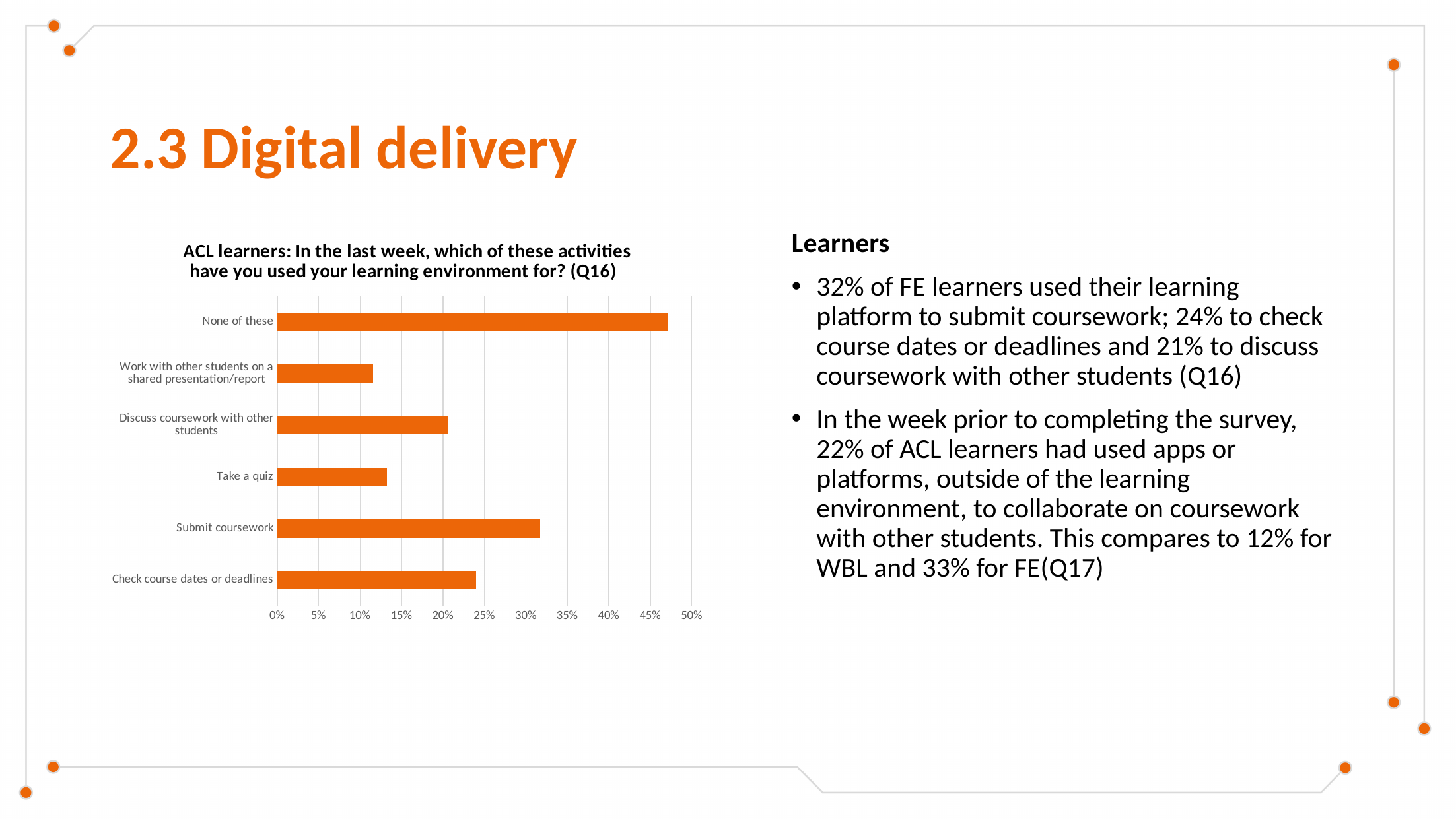
How many activity categories are plotted in the chart? 6 Which is larger: the value for "Submit coursework" or the value for "Check course dates or deadlines"? Submit coursework What is the title of the chart? ACL learners: In the last week, which of these activities have you used your learning environment for? (Q16) Which activity has the highest value in the chart? None of these Is the value for "None of these" greater or less than 45%? greater Is the value for "Discuss coursework with other students" greater or less than 15%? greater Is the value for "Submit coursework" greater or less than 30%? greater What kind of chart is shown on the slide? Bar chart Which is larger: the value for "Discuss coursework with other students" or the value for "Take a quiz"? Discuss coursework with other students